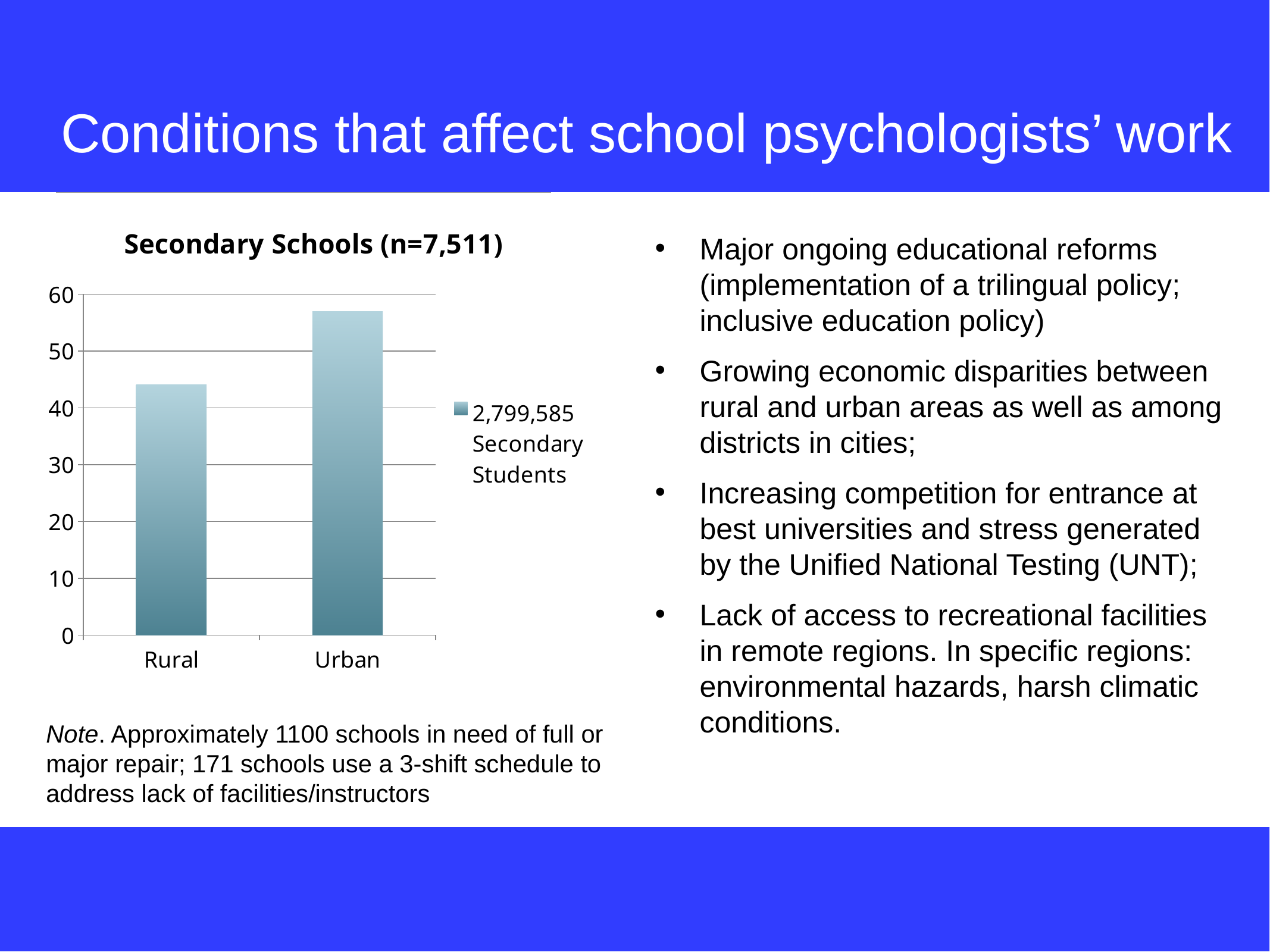
Which category has the lowest bar in the chart? Rural What is the title of the chart? Secondary Schools (n=7,511) Is the value for Rural greater or less than 40? greater What kind of chart is shown on the slide? bar chart What is the legend entry for the series in the chart? 2,799,585 Secondary Students Is the value for Urban greater or less than 50? greater Is the value for Rural greater or less than 50? less How many categories are shown on the x axis of the chart? 2 How many series does the chart's legend list? 1 Which category has the highest bar in the chart? Urban Which is larger in the chart, the value for Rural or the value for Urban? Urban Do the bar values rise or fall going from Rural to Urban along the x axis? rise